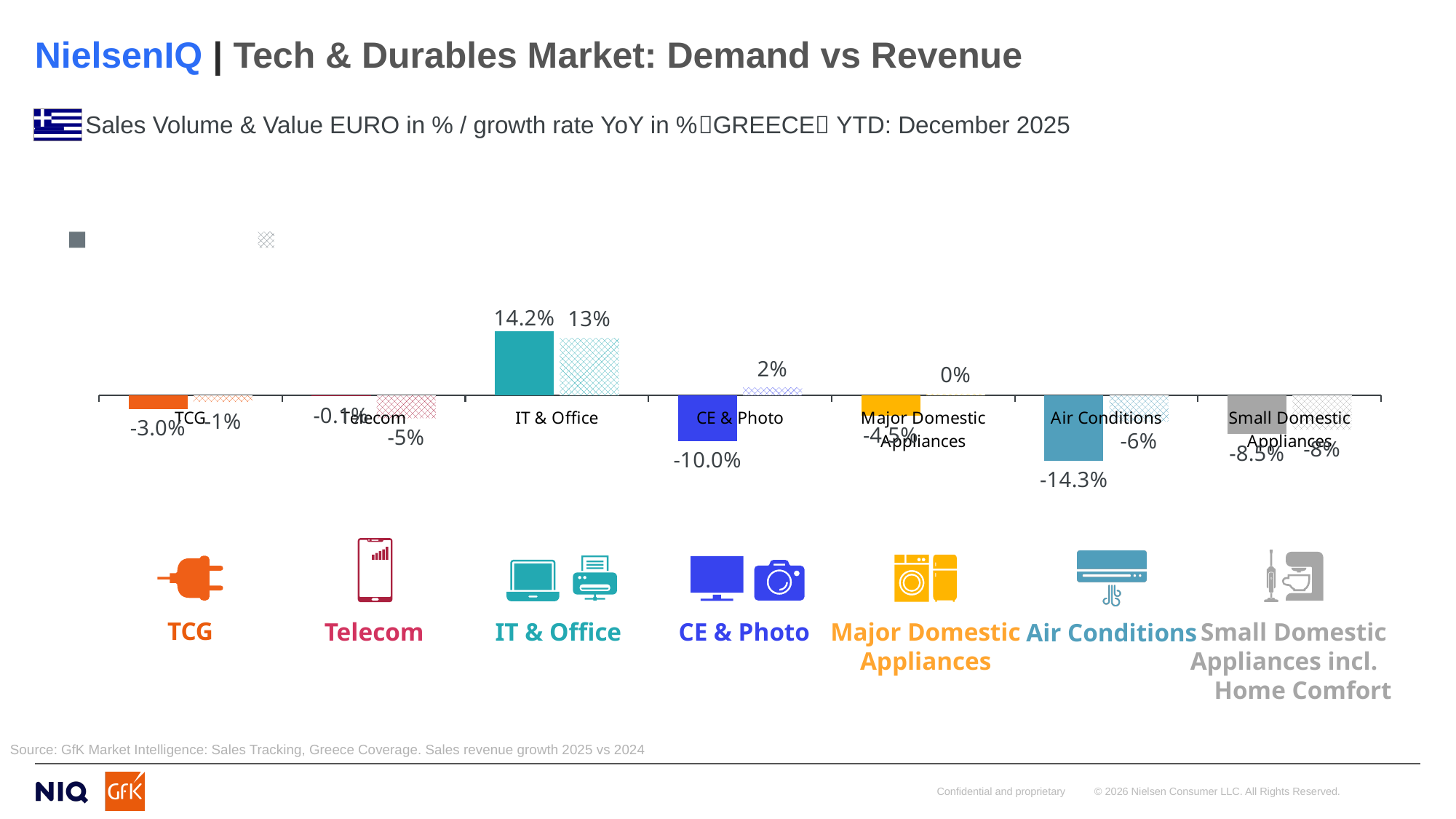
How many series does the chart's legend show? 2 What is the difference between the solid bar (14.2%) and the hatched bar (13%) for IT & Office? 1.2 percentage points What is the value of the hatched bar for Major Domestic Appliances? 0% What is the value of the hatched bar for Air Conditions? -6% Which category has the highest solid-bar value? IT & Office What is the value of the solid bar for CE & Photo? -10.0% What is the value of the solid bar for IT & Office? 14.2% Which has the larger solid-bar value, TCG or Telecom? Telecom Which category has the lowest solid-bar value? Air Conditions What kind of chart is shown on the slide? Bar chart How many categories are shown on the x axis of the chart? 7 What is the difference between the solid bar (-14.3%) and the hatched bar (-6%) for Air Conditions? 8.3 percentage points